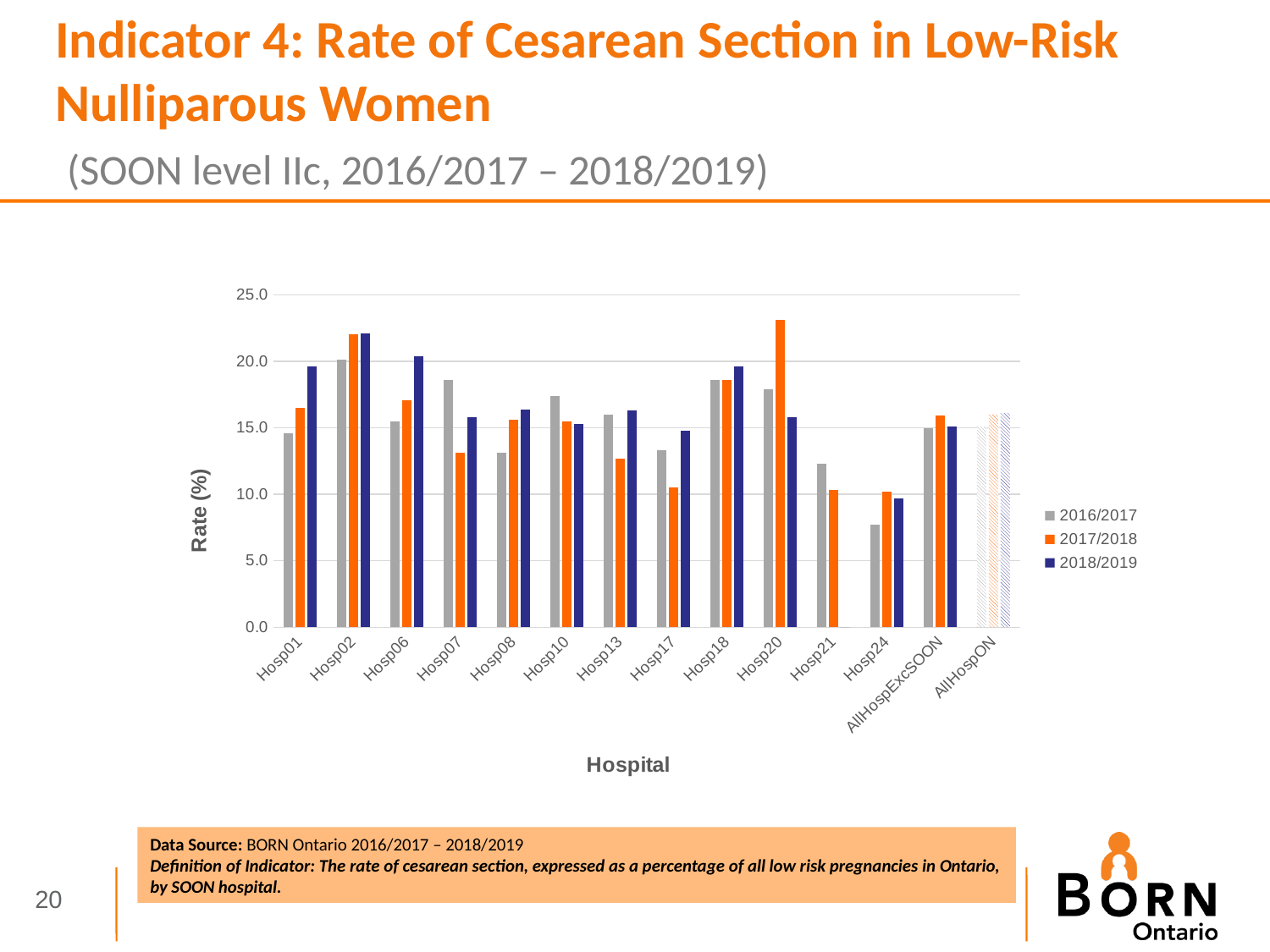
Is the 2017/2018 value for Hosp20 greater or less than 20.0? greater How many series does the legend list? 3 How many hospital categories are shown on the x axis? 14 What kind of chart is shown on the slide? Bar chart For Hosp07, which is larger: the 2016/2017 value or the 2017/2018 value? 2016/2017 Is the 2017/2018 value for Hosp13 greater or less than 15.0? less Which hospital has the lowest 2018/2019 bar? Hosp24 Is the 2016/2017 value for Hosp24 greater or less than 10.0? less What is the label on the y axis of the chart? Rate (%) For Hosp01, which is larger: the 2016/2017 value or the 2018/2019 value? 2018/2019 Which hospital has the lowest 2016/2017 bar? Hosp24 Which hospital has the highest 2017/2018 bar? Hosp20